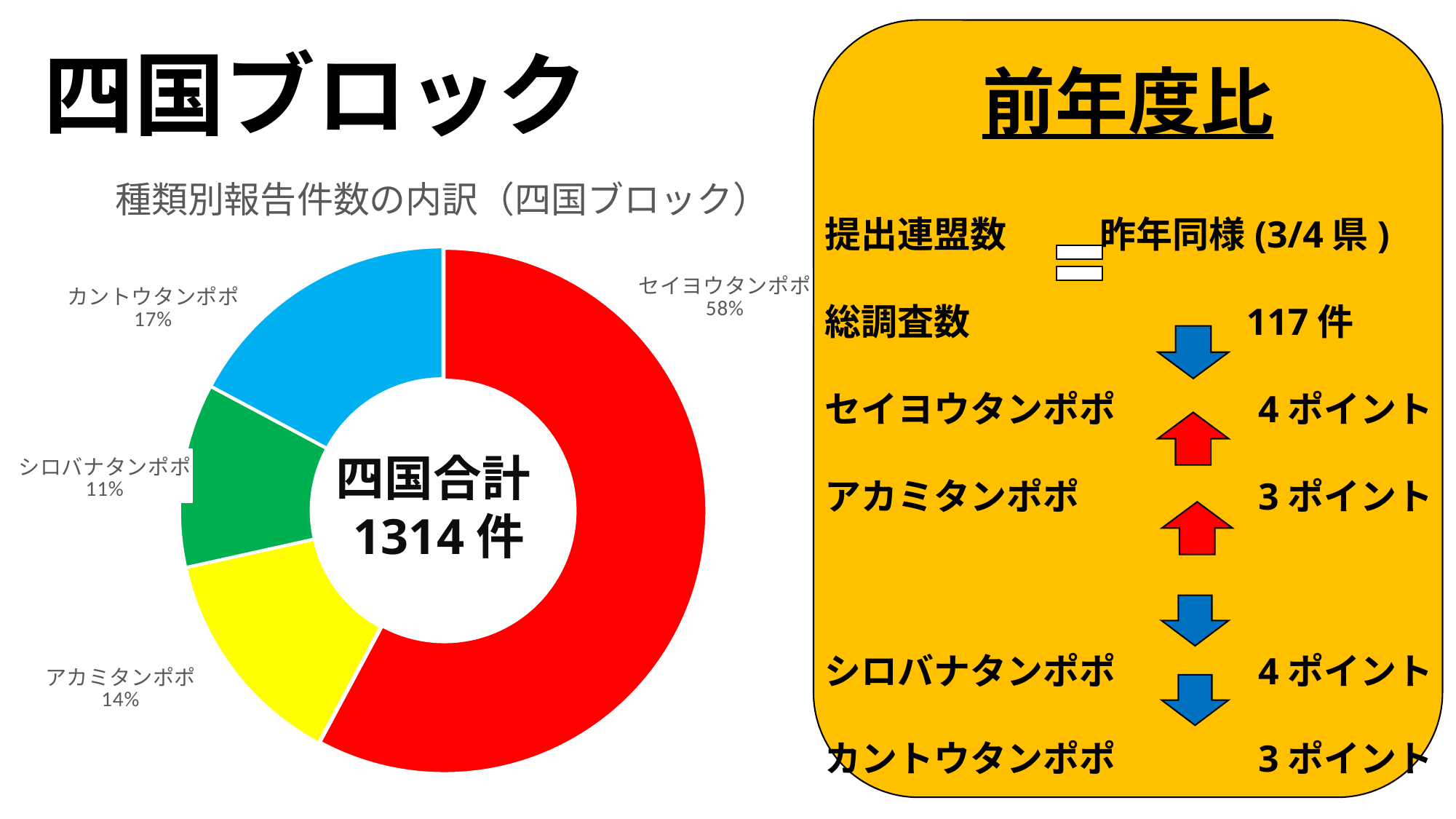
What share of the chart does セイヨウタンポポ account for? 58% What kind of chart is shown on the slide? doughnut chart What is the title of the chart? 種類別報告件数の内訳（四国ブロック） What is the difference in percentage points between セイヨウタンポポ and カントウタンポポ? 41 How many categories are shown in the chart? 4 Which category has the largest share of the chart? セイヨウタンポポ What percentage is shown for アカミタンポポ? 14% Which category has the smallest share of the chart? シロバナタンポポ What total number of cases is shown in the centre of the chart? 1314 件 Which has a larger share, アカミタンポポ or シロバナタンポポ? アカミタンポポ What percentage is shown for カントウタンポポ? 17% What percentage is shown for シロバナタンポポ? 11%